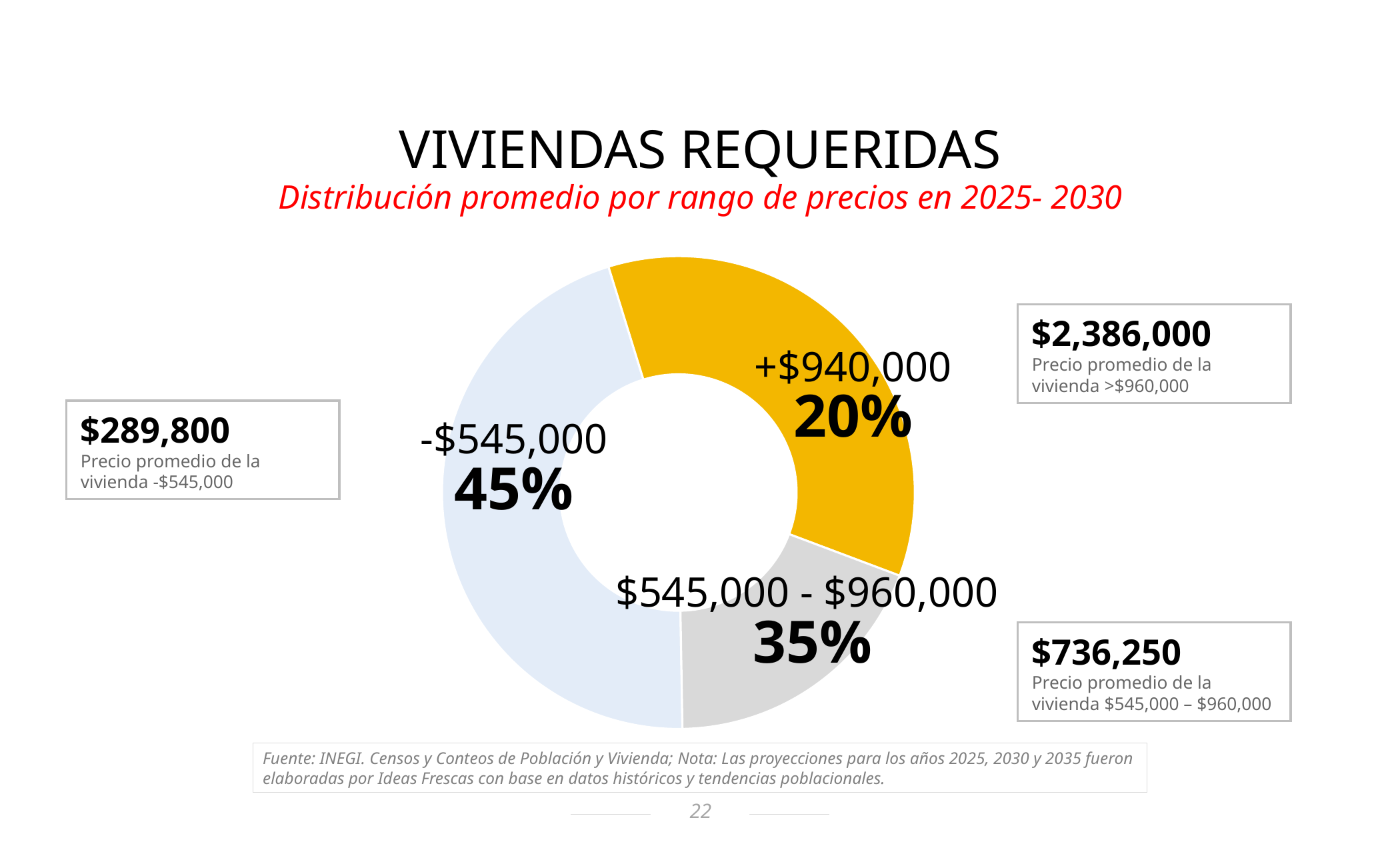
Which price range has the smallest share of the donut chart? +$940,000 What is the red subtitle of the chart on the slide? Distribución promedio por rango de precios en 2025- 2030 Which price range has the largest share of the donut chart? -$545,000 Which slice is larger: $545,000 - $960,000 or +$940,000? $545,000 - $960,000 How many price-range slices does the donut chart have? 3 What share of the donut chart does the +$940,000 price range represent? 20% What is the difference in percentage points between the $545,000 - $960,000 slice and the +$940,000 slice? 15 What share of the donut chart does the -$545,000 price range represent? 45% What colour is the +$940,000 slice of the donut chart? Yellow What kind of chart is shown on the slide? Donut (pie) chart What share of the donut chart does the $545,000 - $960,000 price range represent? 35% What is the difference in percentage points between the -$545,000 slice and the +$940,000 slice? 25